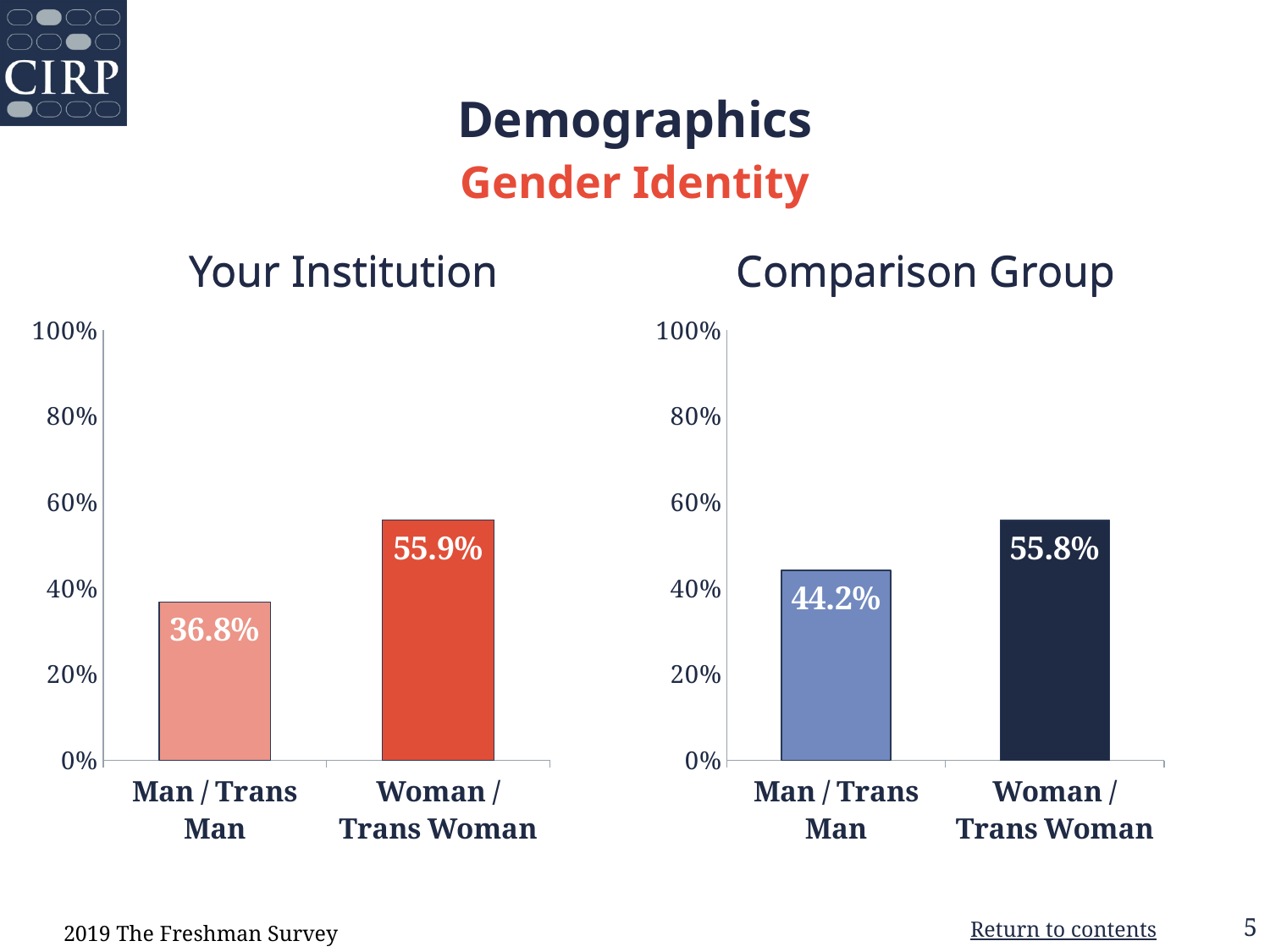
In the Your Institution chart, which category has the highest value? Woman / Trans Woman Is the Man / Trans Man value larger in the Your Institution chart or the Comparison Group chart? Comparison Group In the Comparison Group chart, what is the value for Woman / Trans Woman? 55.8% In the Your Institution chart, is the value for Man / Trans Man greater or less than 40%? less In the Comparison Group chart, what is the value for Man / Trans Man? 44.2% In the Comparison Group chart, what is the difference between the Woman / Trans Woman and Man / Trans Man values? 11.6% In the Comparison Group chart, which category has the lowest value? Man / Trans Man What kind of chart is the Your Institution chart? bar chart In the Your Institution chart, what is the value for Woman / Trans Woman? 55.9% In the Your Institution chart, what is the value for Man / Trans Man? 36.8% In the Your Institution chart, what is the difference between the Woman / Trans Woman and Man / Trans Man values? 19.1% How many categories are shown in the Comparison Group chart? 2